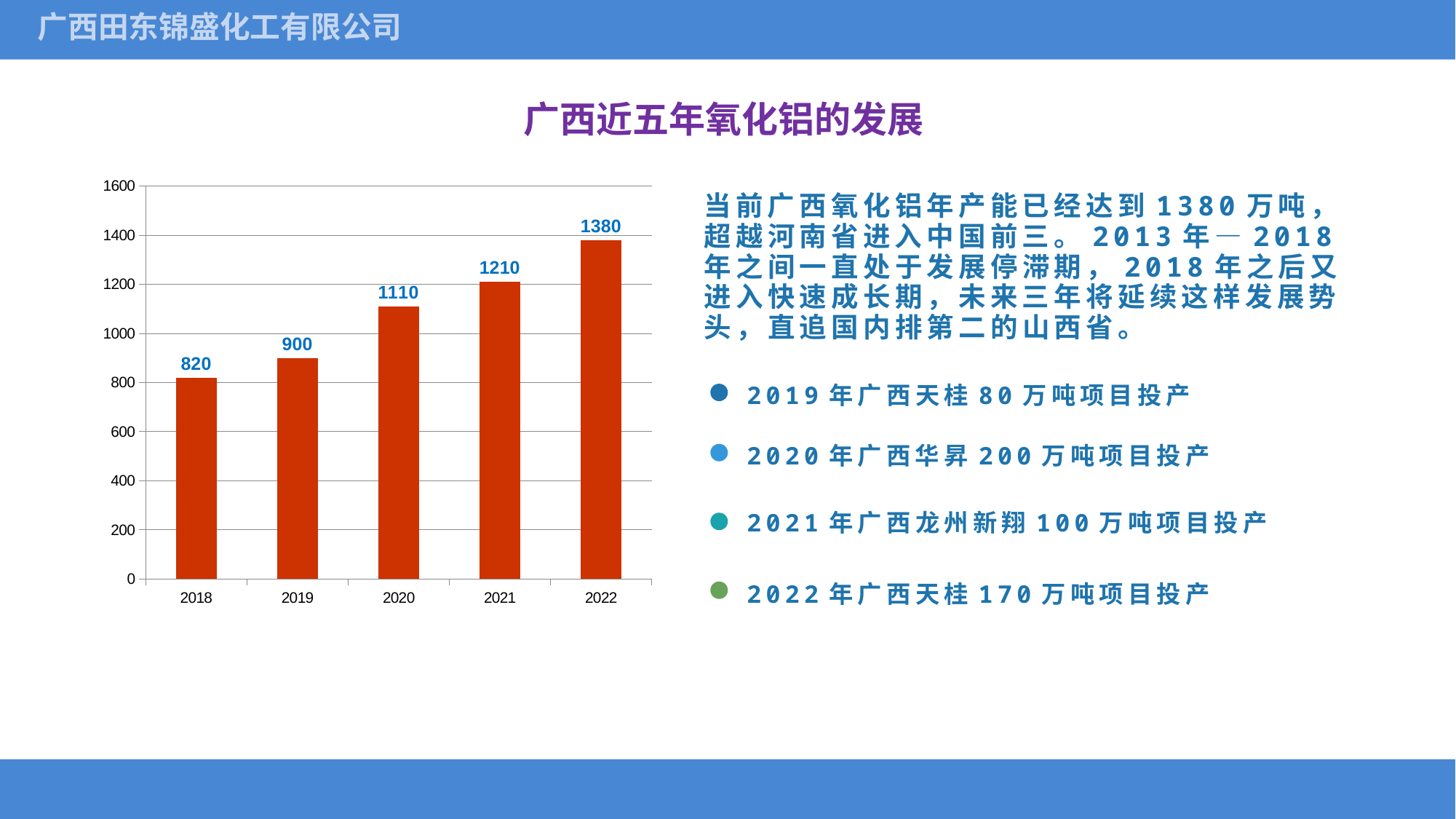
What is the value for 2022? 1380 Do the values rise or fall from 2018 to 2022? rise Which year has the highest value? 2022 Which is larger, the value for 2019 or the value for 2021? 2021 What is the difference between the values for 2021 and 2020? 100 How many years are shown on the x axis? 5 What is the value for 2020? 1110 What kind of chart is shown on the slide? bar chart Is the value for 2019 greater or less than 1000? less What is the difference between the values for 2022 and 2018? 560 What is the value for 2018? 820 Which year has the lowest value? 2018